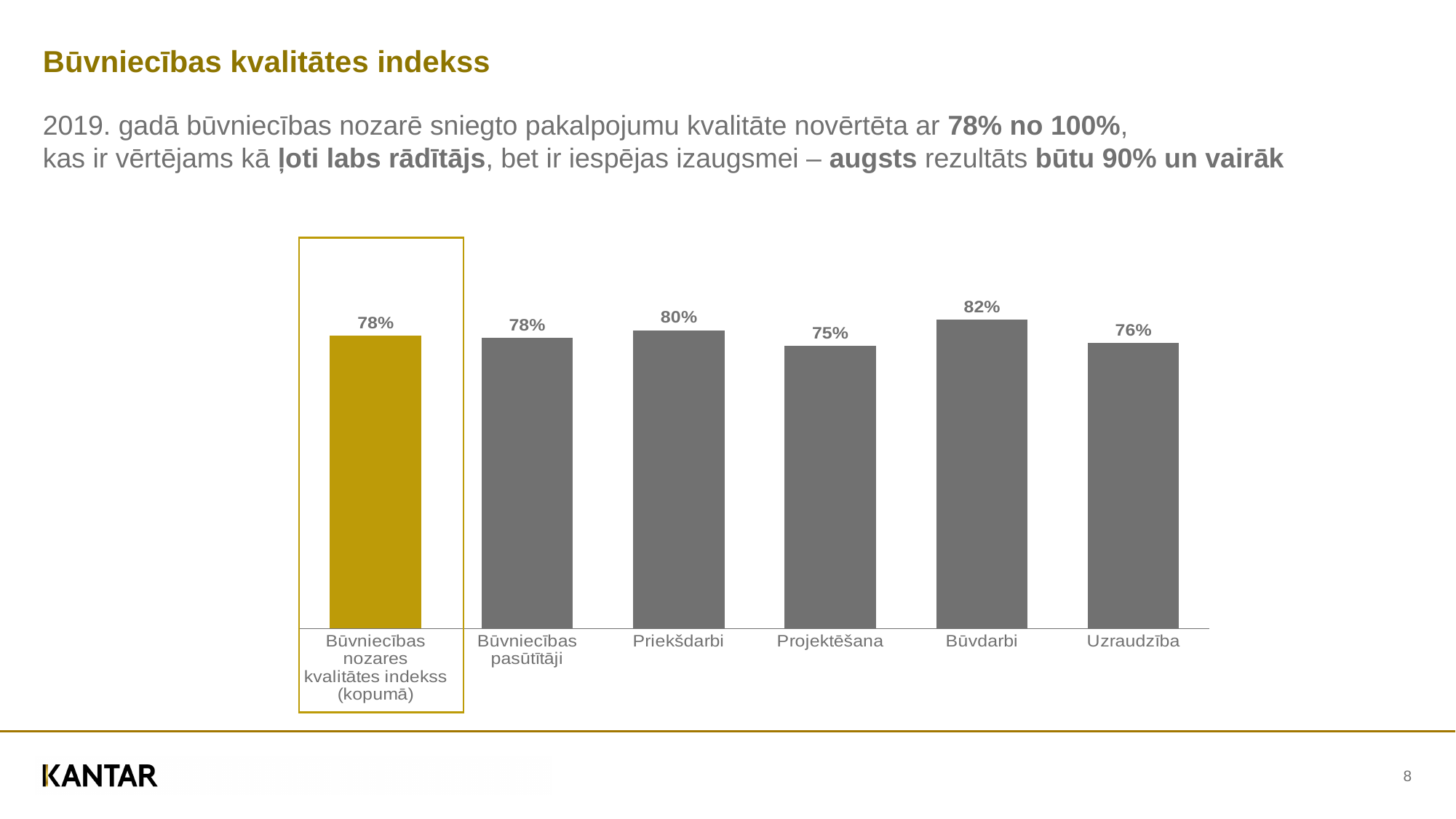
Which is larger, the value for Priekšdarbi or the value for Uzraudzība? Priekšdarbi Which bar is highlighted in a different colour (gold) from the others? Būvniecības nozares kvalitātes indekss (kopumā) Which category has the lowest value? Projektēšana How many categories are shown in the chart? 6 What is the value for Projektēšana? 75% What is the value for Uzraudzība? 76% What is the value for Būvniecības nozares kvalitātes indekss (kopumā)? 78% Which category has the highest value? Būvdarbi What is the value for Būvdarbi? 82% What is the difference between the values for Būvdarbi and Projektēšana? 7% What is the difference between the values for Priekšdarbi and Būvniecības pasūtītāji? 2% What kind of chart is shown on the slide? Bar chart